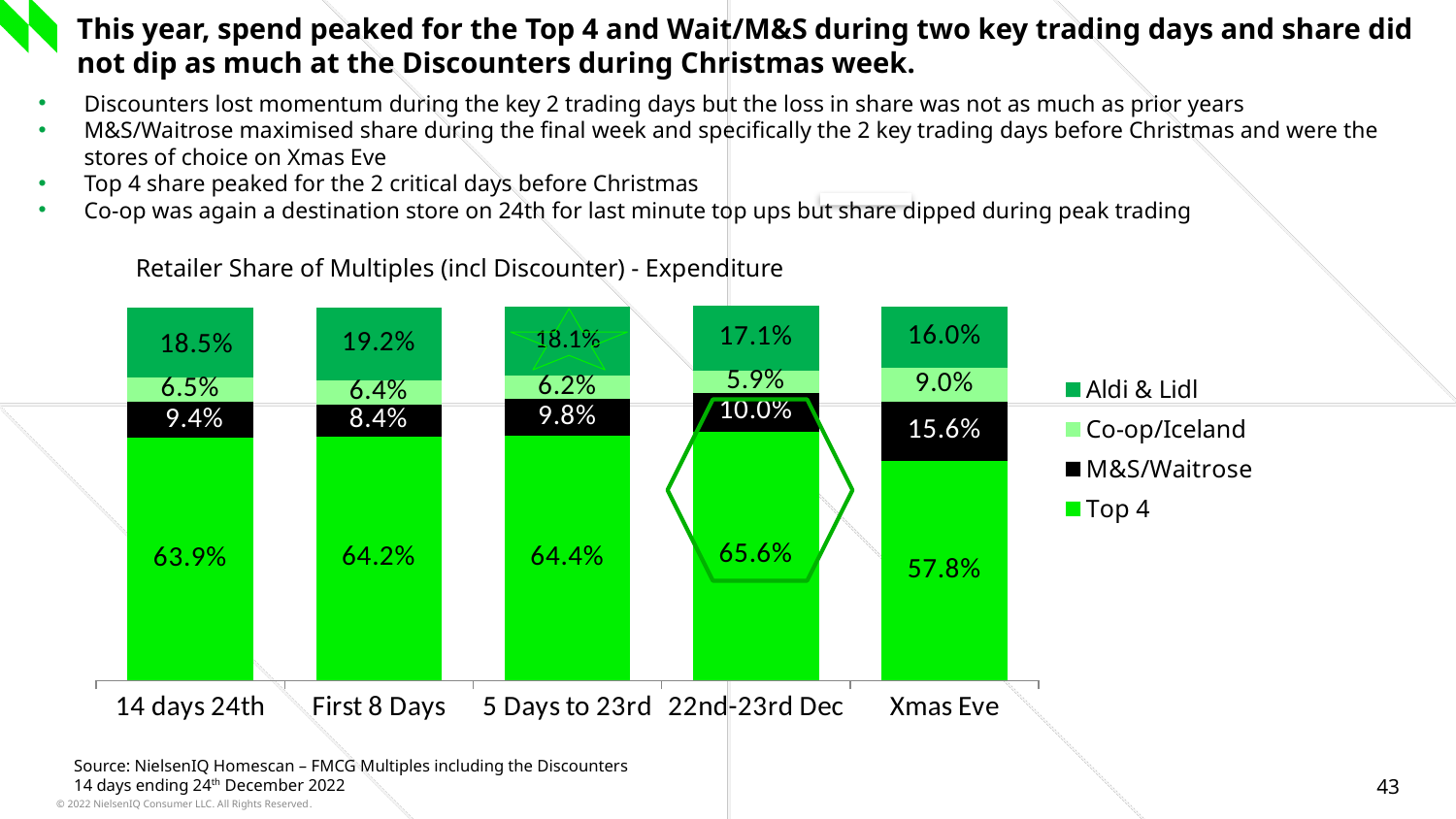
What is the M&S/Waitrose share for 22nd-23rd Dec? 10.0% In which period is the Top 4 share highest? 22nd-23rd Dec In which period is the Aldi & Lidl share lowest? Xmas Eve What is the Top 4 share on Xmas Eve? 57.8% What kind of chart is shown? Stacked bar chart What is the difference between the M&S/Waitrose share on Xmas Eve and for 14 days 24th? 6.2% What is the title of the chart? Retailer Share of Multiples (incl Discounter) - Expenditure What is the Aldi & Lidl share for First 8 Days? 19.2% How many series does the legend list? 4 Which is larger: the Co-op/Iceland share on Xmas Eve or for 22nd-23rd Dec? Xmas Eve How many periods are shown on the x axis? 5 What is the Co-op/Iceland share for 5 Days to 23rd? 6.2%